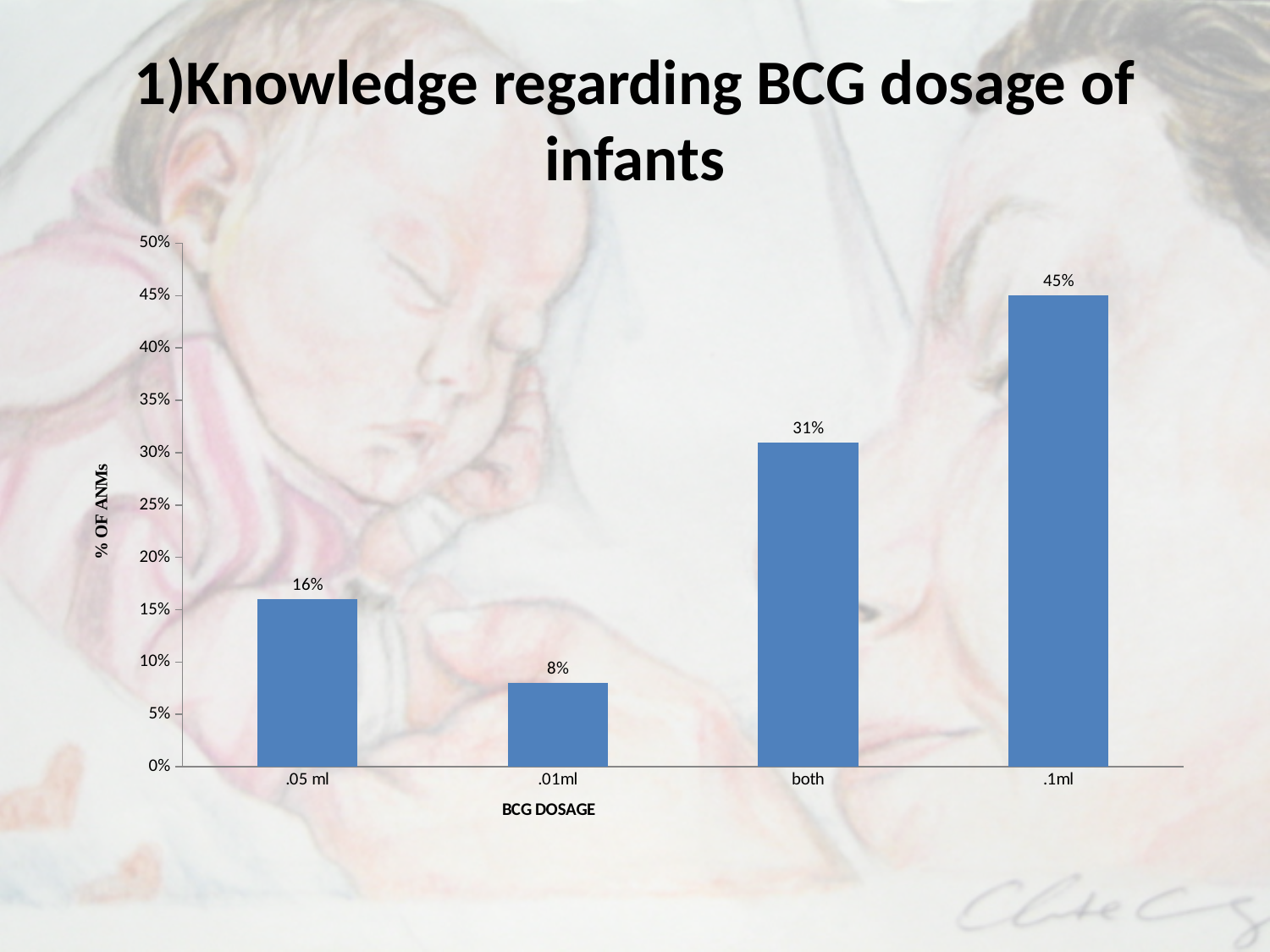
What percentage of ANMs answered 'both' for BCG dosage? 31% How many BCG dosage categories are shown on the x axis? 4 What is the label of the y axis? % OF ANMs What is the difference in percentage of ANMs between .1ml and 'both'? 14% Which BCG dosage category has the highest percentage of ANMs? .1ml What is the difference in percentage of ANMs between .05 ml and .01ml? 8% What kind of chart is shown on the slide? Bar chart What percentage of ANMs answered .1ml for BCG dosage? 45% What percentage of ANMs answered .05 ml for BCG dosage? 16% Which BCG dosage category has the lowest percentage of ANMs? .01ml What percentage of ANMs answered .01ml for BCG dosage? 8% Which has a larger percentage of ANMs, .05 ml or 'both'? both